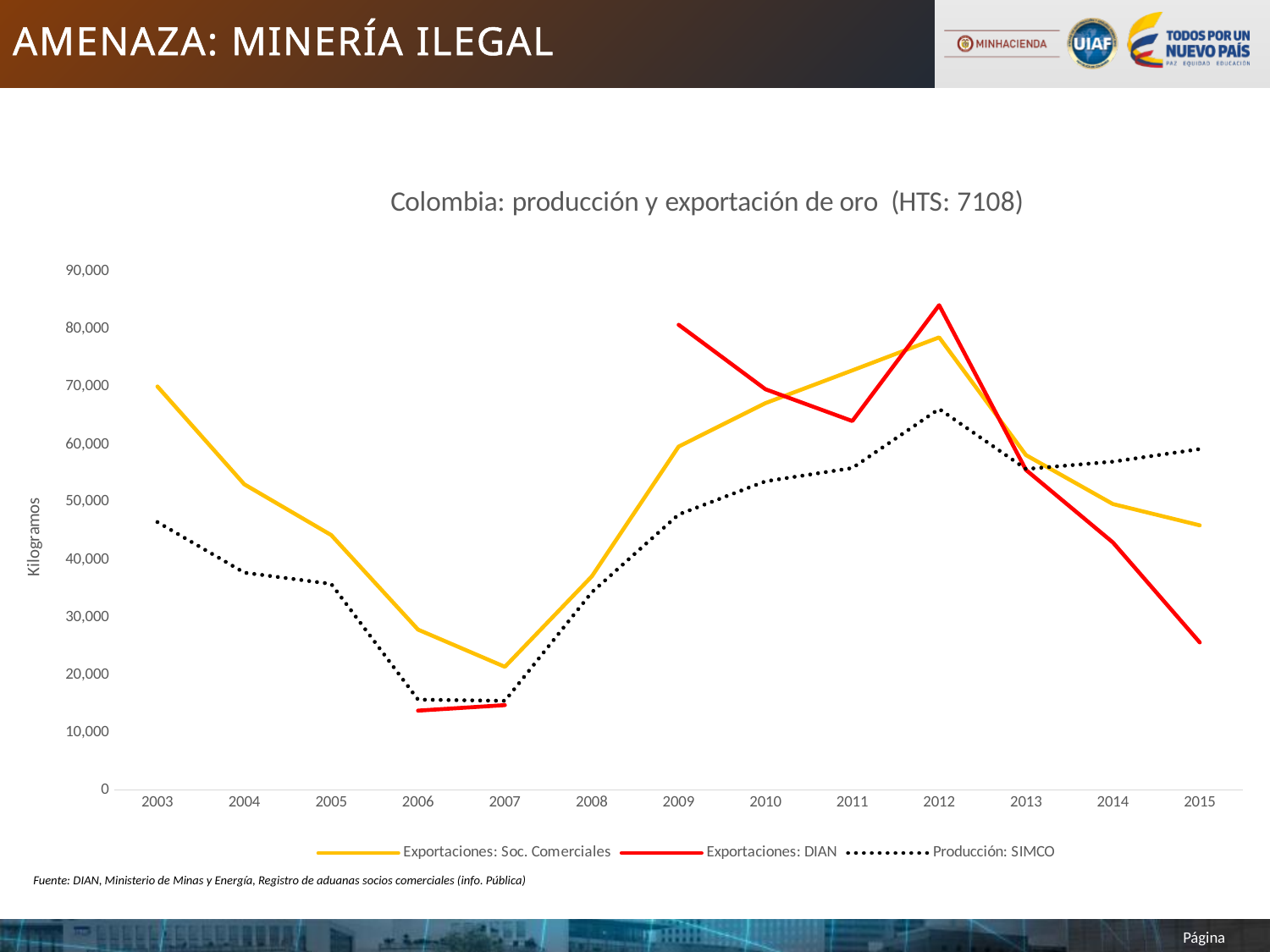
In which year does the Producción: SIMCO series reach its highest value? 2012 Is the value for Exportaciones: DIAN in 2015 greater or less than 30,000? less In which year does the Exportaciones: DIAN series reach its highest value? 2012 What is the title of the chart? Colombia: producción y exportación de oro (HTS: 7108) How many series does the legend list? 3 Does the Exportaciones: DIAN series rise or fall from 2012 to 2015? fall What is the label on the vertical axis? Kilogramos Is the value for Exportaciones: DIAN in 2012 greater or less than 80,000? greater In which year does the Exportaciones: Soc. Comerciales series reach its lowest value? 2007 How many years are shown on the x axis? 13 What kind of chart is shown on the slide? line chart In 2015, which is larger: Exportaciones: Soc. Comerciales or Exportaciones: DIAN? Exportaciones: Soc. Comerciales